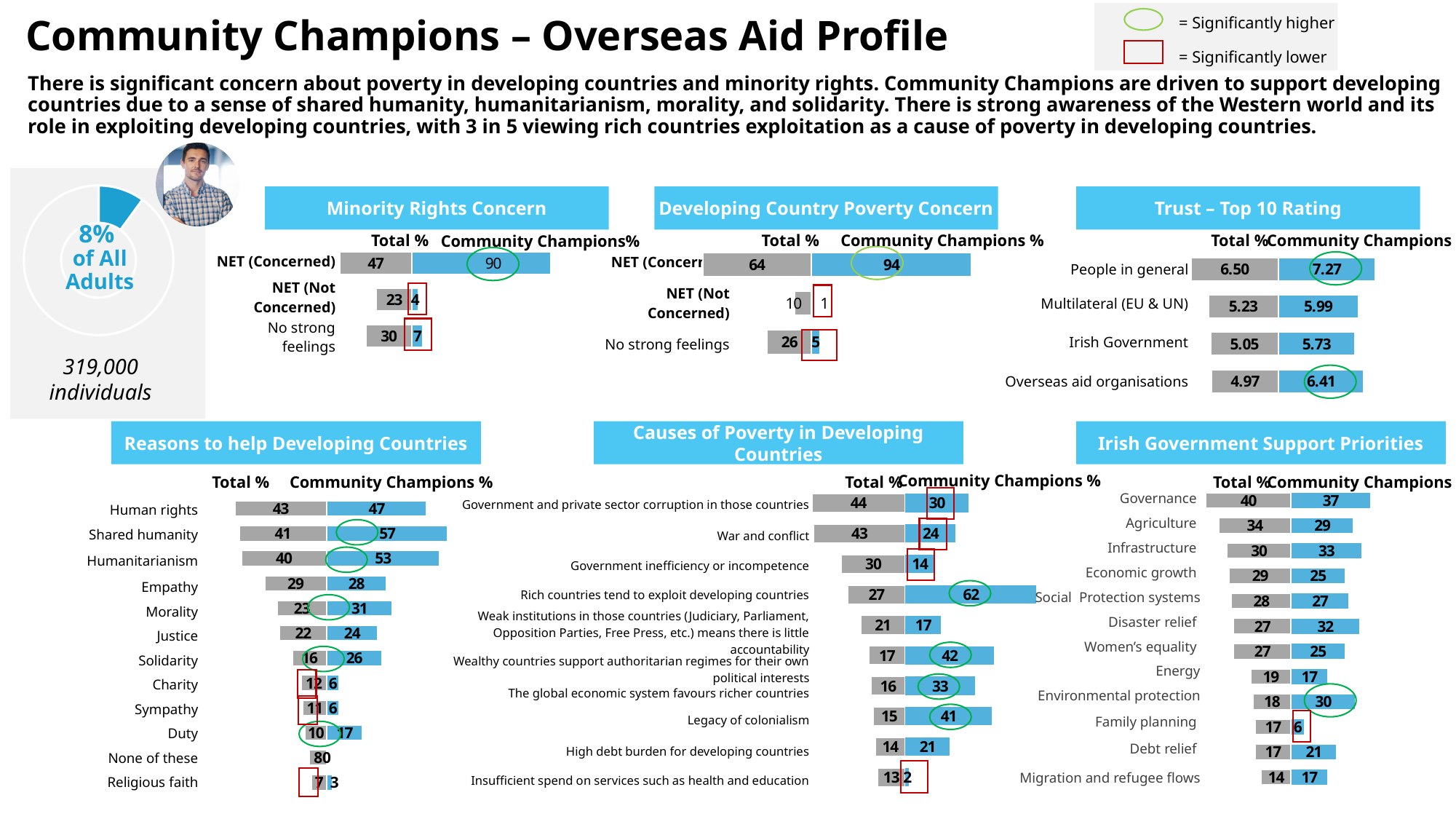
How many data series does the Reasons to help Developing Countries chart show? 2 What kind of chart is the Reasons to help Developing Countries chart? Bar chart In the Reasons to help Developing Countries chart, which reason has the highest Community Champions %? Shared humanity In the Minority Rights Concern chart, what is the Community Champions % for NET (Concerned)? 90 In the Developing Country Poverty Concern chart, what is the Total % for NET (Concerned)? 64 In the Causes of Poverty in Developing Countries chart, what is the Community Champions % for 'Rich countries tend to exploit developing countries'? 62 In the Trust – Top 10 Rating chart, what is the Community Champions rating for Overseas aid organisations? 6.41 In the Causes of Poverty in Developing Countries chart, what is the difference between the Community Champions % and the Total % for Legacy of colonialism? 26 In the Irish Government Support Priorities chart, which has the larger Community Champions value: Environmental protection or Family planning? Environmental protection In the Trust – Top 10 Rating chart, what is the difference between the Community Champions rating and the Total rating for People in general? 0.77 In the Irish Government Support Priorities chart, what is the Total % for Governance? 40 In the Reasons to help Developing Countries chart, what is the Community Champions % for Shared humanity? 57